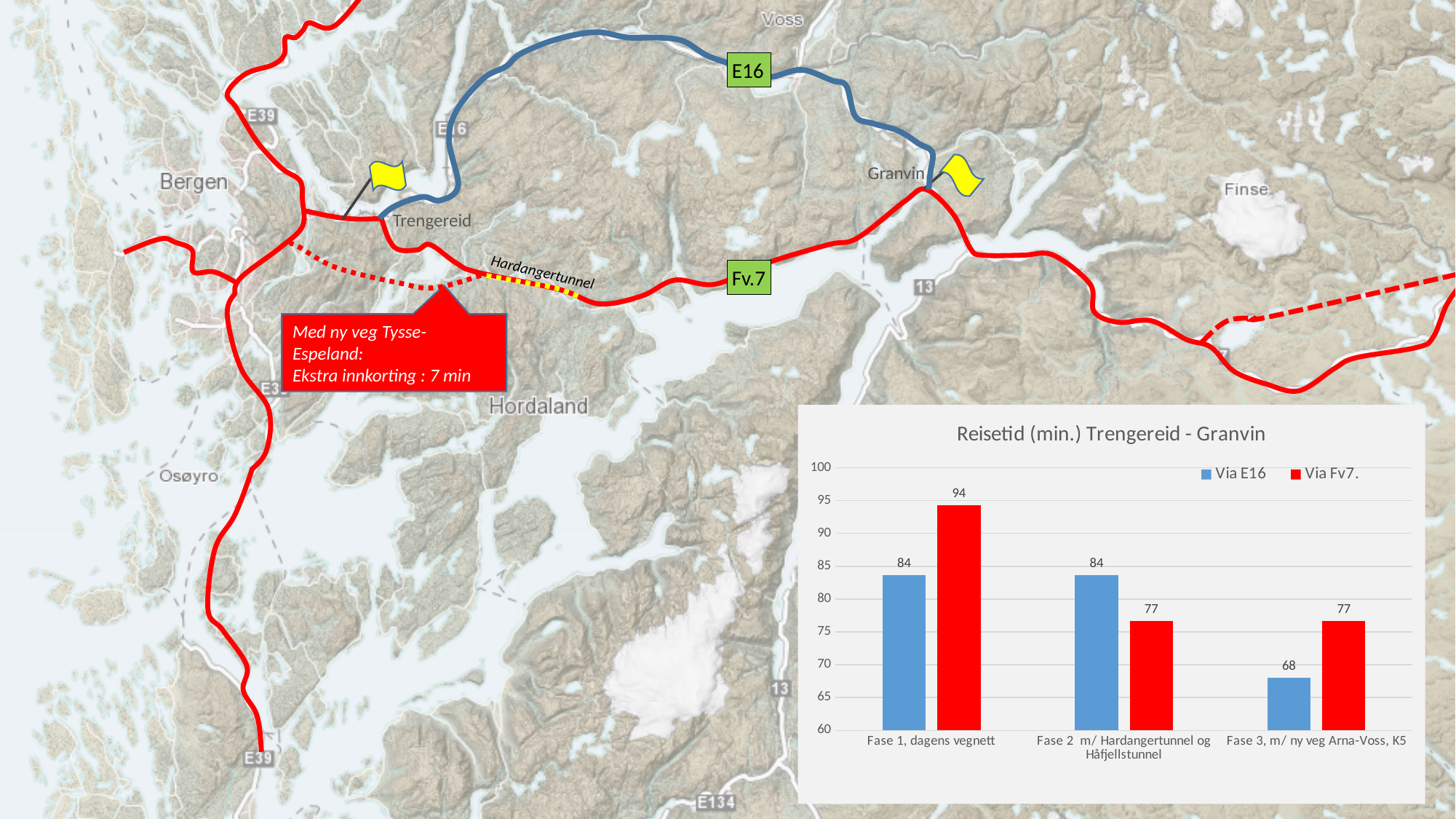
What is the value for Via Fv7. in Fase 2 m/ Hardangertunnel og Håfjellstunnel? 77 What is the value for Via E16 in Fase 3, m/ ny veg Arna-Voss, K5? 68 Which category has the highest value for Via Fv7.? Fase 1, dagens vegnett In Fase 2 m/ Hardangertunnel og Håfjellstunnel, which is larger: Via E16 or Via Fv7.? Via E16 Which category has the lowest value for Via E16? Fase 3, m/ ny veg Arna-Voss, K5 How many series does the chart legend list? 2 How many categories are shown on the x axis of the chart? 3 What type of chart is shown on the slide? bar chart What is the title of the chart? Reisetid (min.) Trengereid - Granvin What is the difference between Via Fv7. and Via E16 in Fase 1, dagens vegnett? 10 What is the value for Via Fv7. in Fase 1, dagens vegnett? 94 Does the Via E16 value rise or fall from Fase 2 to Fase 3? fall